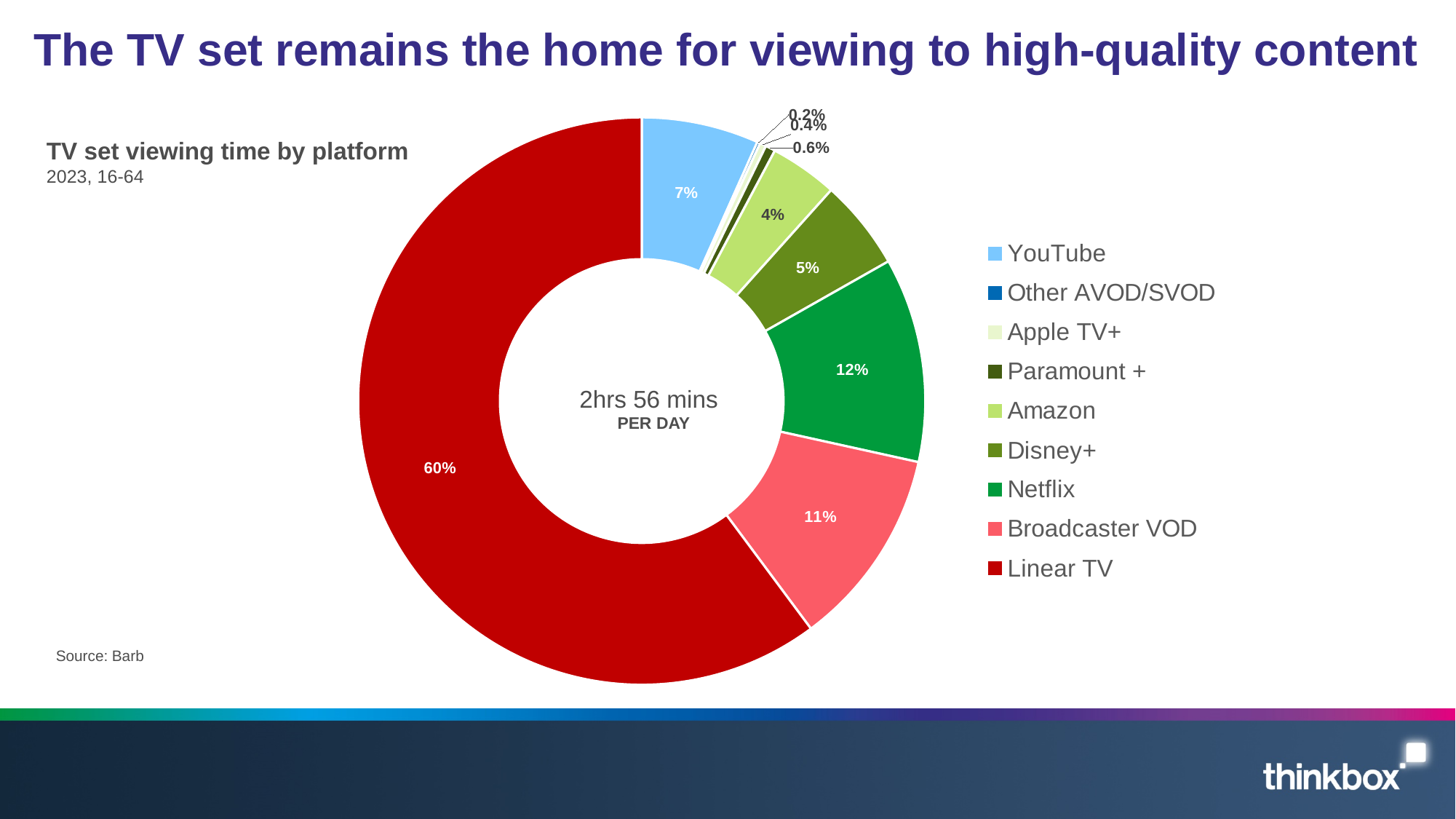
What type of chart is used to show TV set viewing time by platform? Pie (donut) chart How many percentage points larger is Linear TV's share than Netflix's share? 48 How many platforms are listed in the chart legend? 9 Which has a larger share of TV set viewing time, Netflix or Broadcaster VOD? Netflix What share of TV set viewing time does Linear TV account for? 60% What share is shown for Amazon? 4% What is the share shown for Broadcaster VOD? 11% What percentage of TV set viewing time goes to YouTube? 7% What total daily viewing time is shown in the centre of the chart? 2hrs 56 mins per day Which platform has the largest share of TV set viewing time? Linear TV What percentage of TV set viewing time is attributed to Netflix? 12% What share is shown for Disney+? 5%